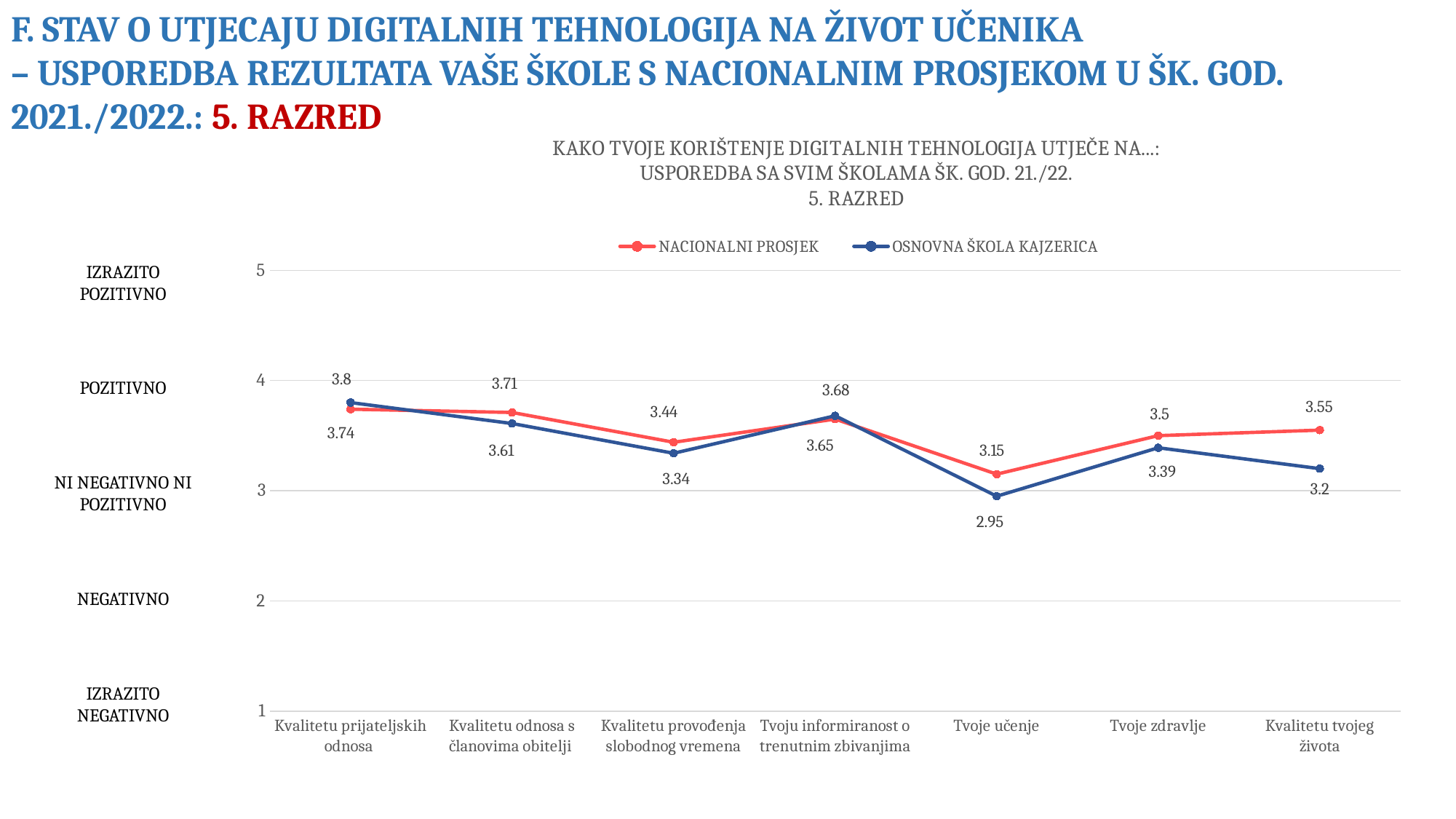
What is the difference between NACIONALNI PROSJEK and OSNOVNA ŠKOLA KAJZERICA for 'Kvalitetu tvojeg života'? 0.35 What is the value for NACIONALNI PROSJEK for 'Kvalitetu tvojeg života'? 3.55 Which category has the highest value for NACIONALNI PROSJEK? Kvalitetu prijateljskih odnosa What type of chart is shown on the slide? line chart How many categories are shown on the x axis? 7 What is the value for OSNOVNA ŠKOLA KAJZERICA for 'Kvalitetu prijateljskih odnosa'? 3.8 Which colour is used for the OSNOVNA ŠKOLA KAJZERICA line? blue For 'Tvoje zdravlje', which series has the larger value, NACIONALNI PROSJEK or OSNOVNA ŠKOLA KAJZERICA? NACIONALNI PROSJEK Which category has the lowest value for OSNOVNA ŠKOLA KAJZERICA? Tvoje učenje How many series does the legend list? 2 What is the value for OSNOVNA ŠKOLA KAJZERICA for 'Tvoje učenje'? 2.95 Is the value for OSNOVNA ŠKOLA KAJZERICA for 'Tvoje učenje' greater or less than 3? less